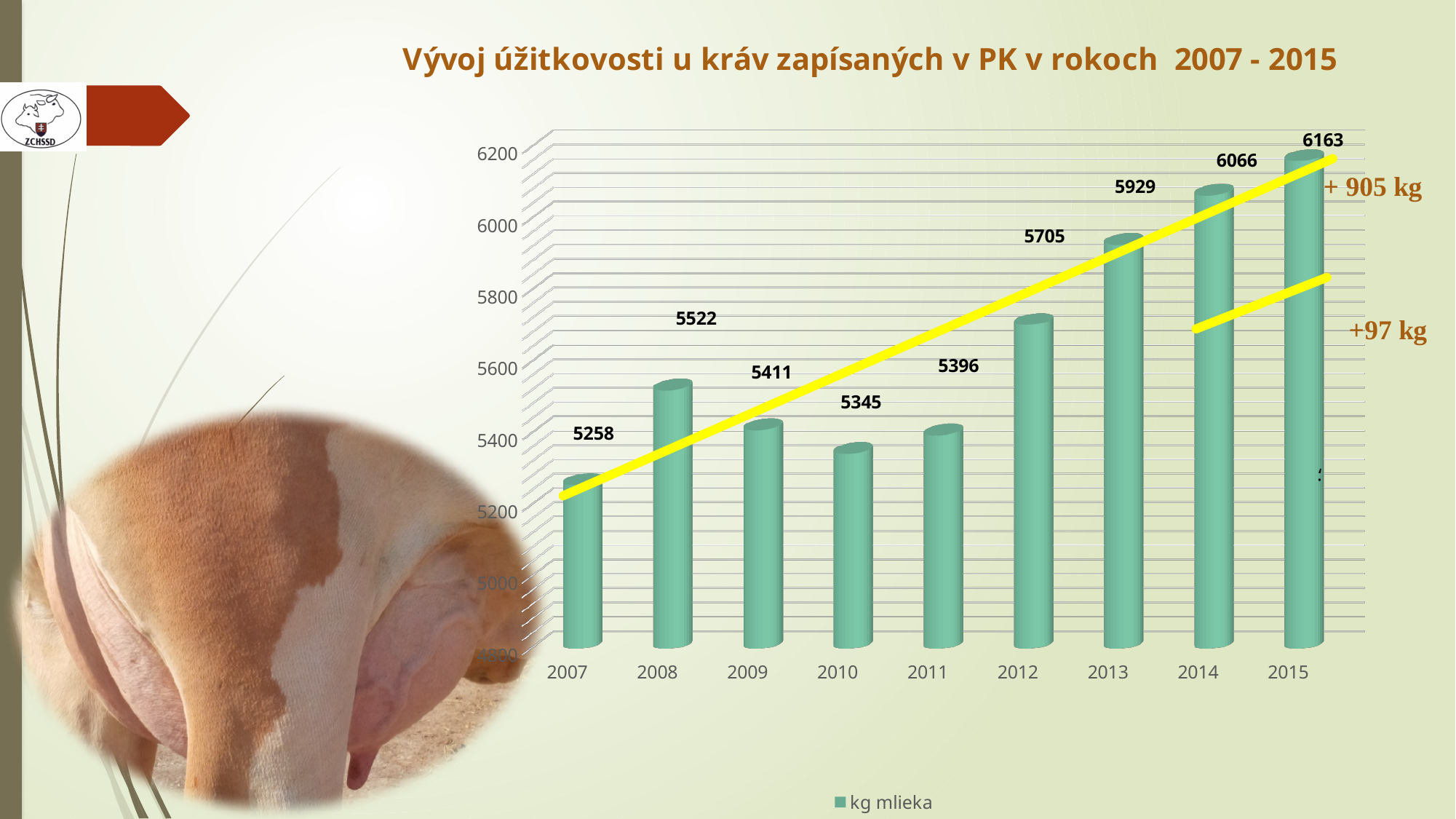
Which year has the highest value? 2015 Is the value for 2013 greater or less than 5800? greater What series name does the legend show? kg mlieka Which year has the lowest value? 2007 What is the value for 2007? 5258 What is the difference between the values for 2008 and 2009? 111 What kind of chart is shown on the slide? bar chart What is the value for 2012? 5705 How many years are shown on the x axis? 9 What is the value for 2014? 6066 What is the difference between the values for 2015 and 2007? 905 Which is larger, the value for 2010 or the value for 2011? 2011